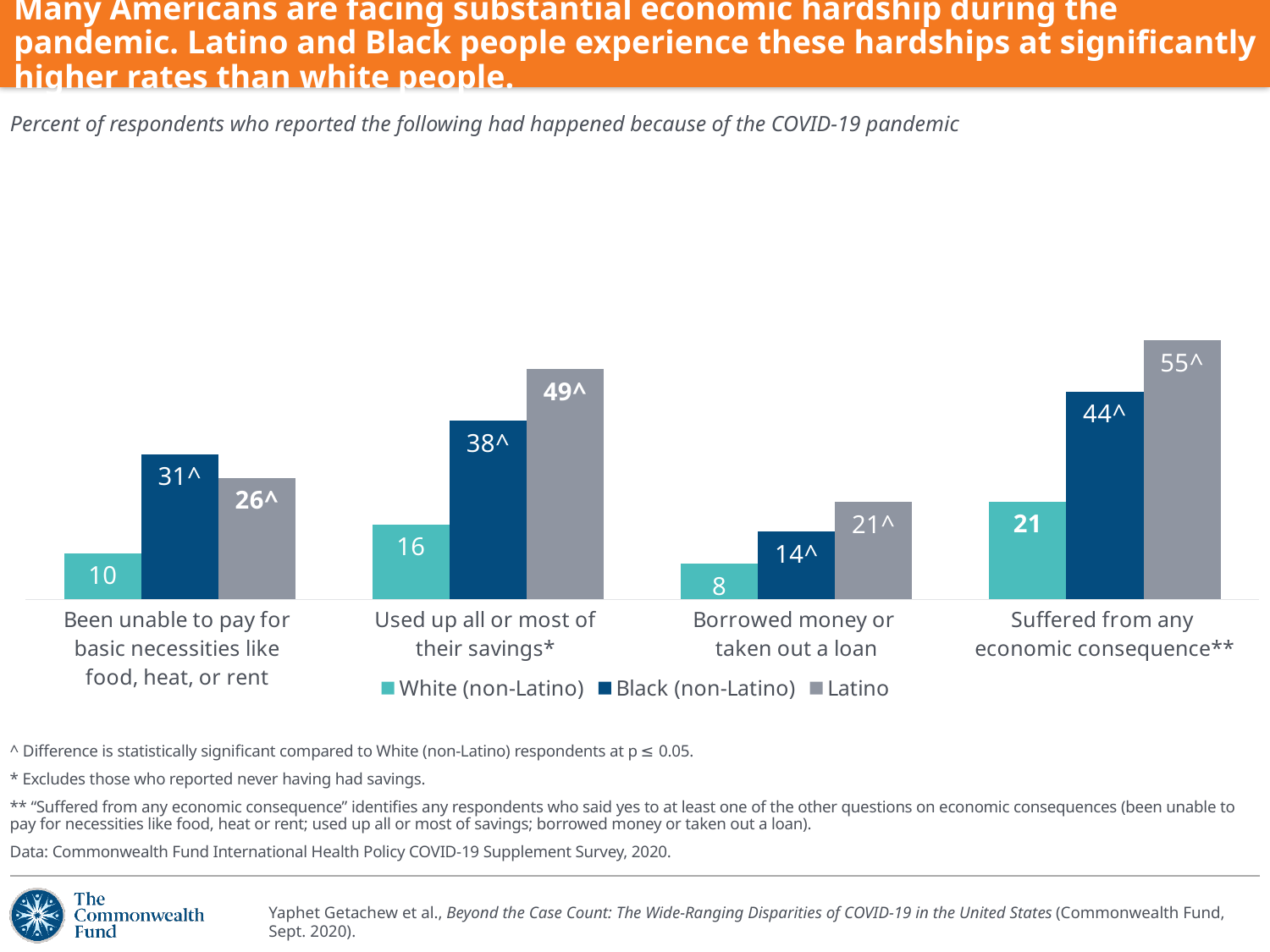
Which is larger: the Black (non-Latino) value for 'Used up all or most of their savings' or the Latino value for 'Been unable to pay for basic necessities'? Black (non-Latino) value for 'Used up all or most of their savings' What percent of White (non-Latino) respondents reported being unable to pay for basic necessities like food, heat, or rent? 10 How many categories are shown on the x axis? 4 What kind of chart is shown on the slide? Bar chart Which group has the lowest value for 'Borrowed money or taken out a loan'? White (non-Latino) What is the difference between the Black (non-Latino) and Latino values for 'Been unable to pay for basic necessities like food, heat, or rent'? 5 What is the difference between the Latino and White (non-Latino) values for 'Suffered from any economic consequence'? 34 Which series is shown in the dark blue bars? Black (non-Latino) Which group has the highest value for 'Suffered from any economic consequence'? Latino What value is shown for Black (non-Latino) respondents who borrowed money or taken out a loan? 14^ How many series does the legend list? 3 What value is shown for Latino respondents who used up all or most of their savings? 49^